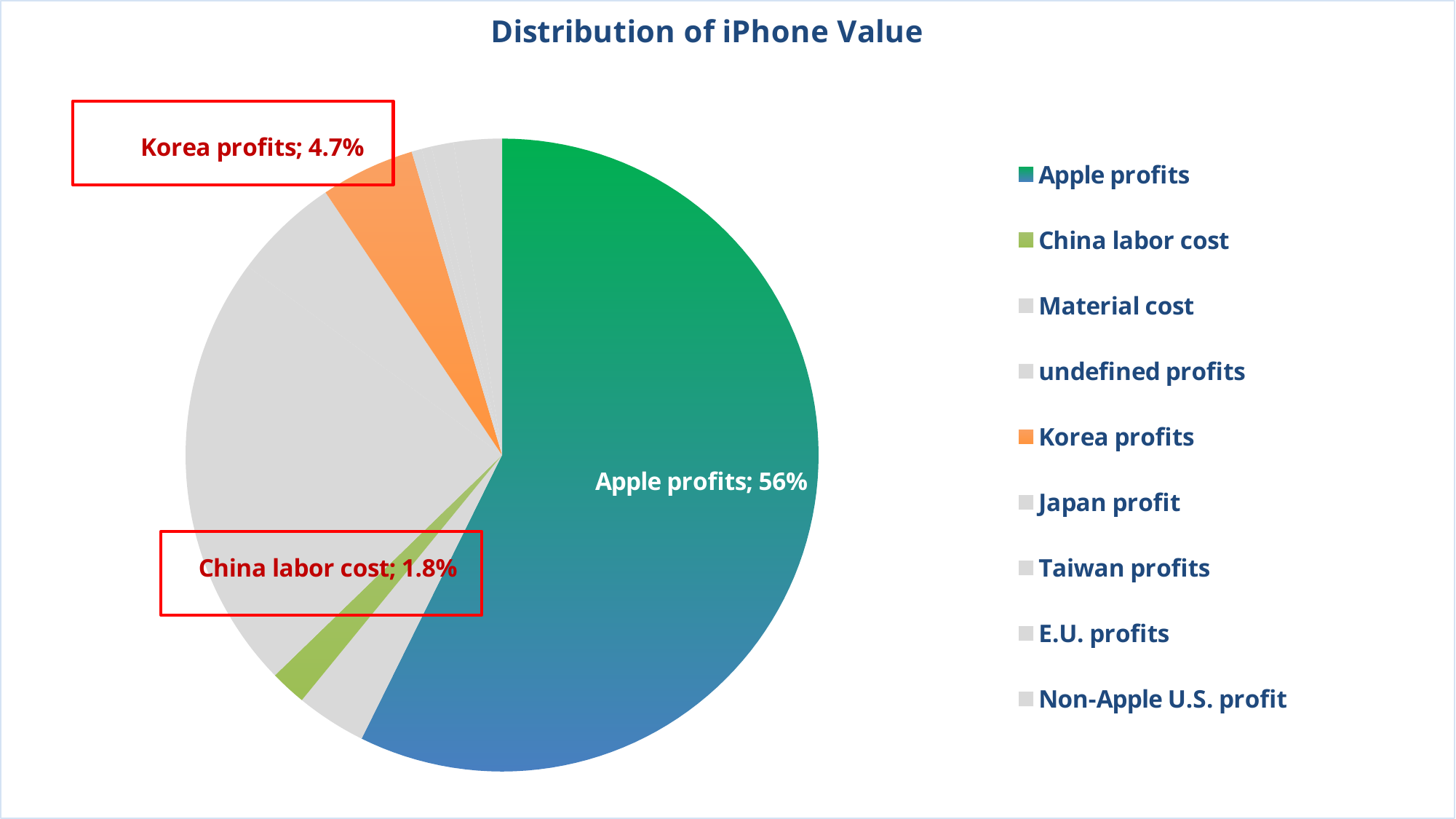
What is the difference between the Apple profits share and the Korea profits share? 51.3% Is the Apple profits share greater or less than 50%? greater What kind of chart is shown on the slide? Pie chart What is the difference between the Korea profits share and the China labor cost share? 2.9% How many categories does the legend list? 9 What is the title of the chart? Distribution of iPhone Value What colour is the Korea profits slice? Orange Which category has the largest slice of the pie? Apple profits What is the value shown for Korea profits? 4.7% What share of iPhone value is labelled as Apple profits? 56% What is the value shown for China labor cost? 1.8% Which is larger, Korea profits or China labor cost? Korea profits